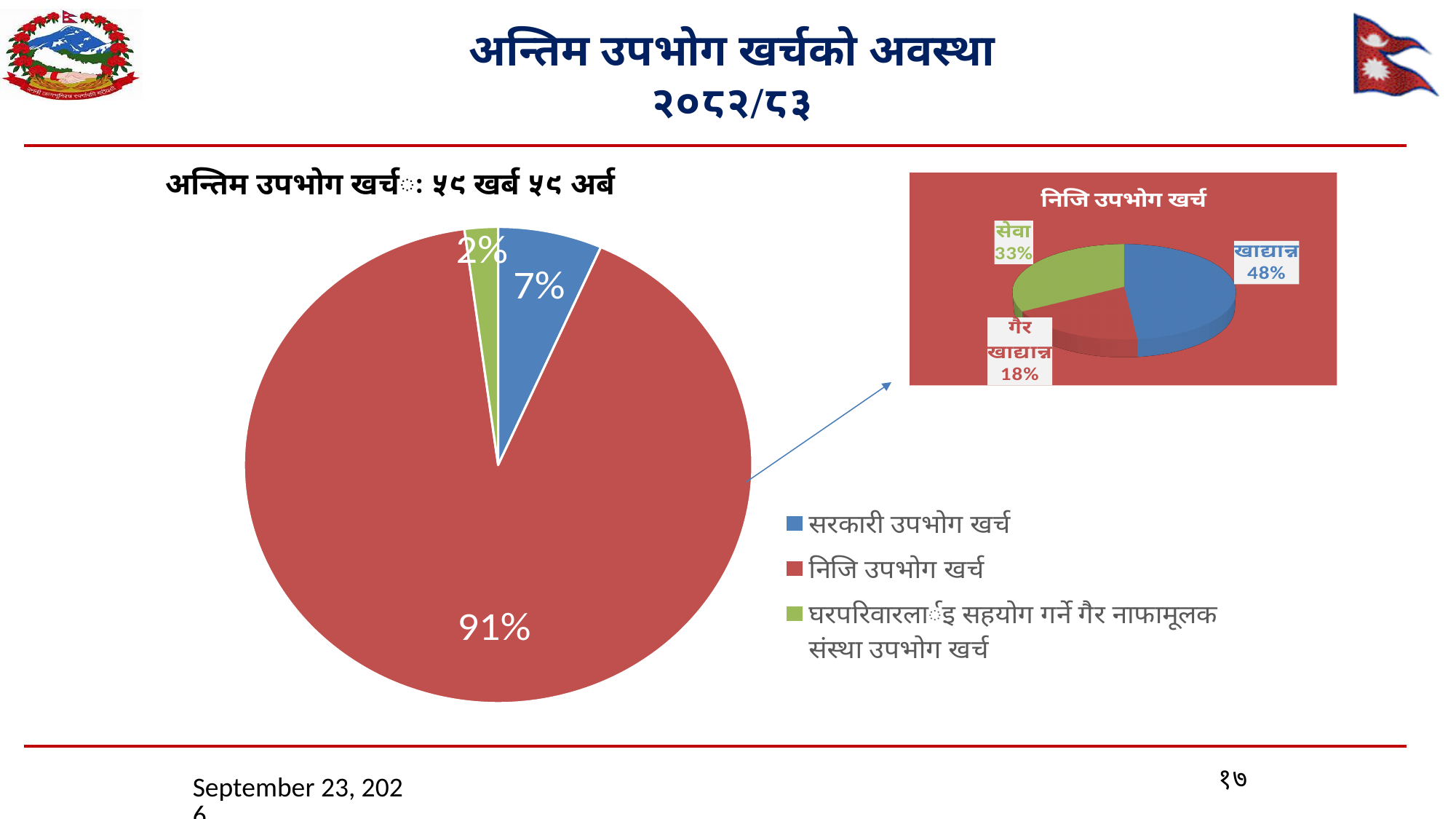
On the large pie chart on the left, how many entries does the legend list? 3 On the large pie chart on the left, which category has the smallest slice? घरपरिवारलाई सहयोग गर्ने गैर नाफामूलक संस्था उपभोग खर्च On the chart titled निजि उपभोग खर्च, what share is labelled for सेवा? 33% What kind of chart is the chart titled निजि उपभोग खर्च on the right? Pie chart On the large pie chart on the left, which category has the largest slice? निजि उपभोग खर्च On the large pie chart on the left, what share is labelled for घरपरिवारलाई सहयोग गर्ने गैर नाफामूलक संस्था उपभोग खर्च? 2% On the chart titled निजि उपभोग खर्च, which category has the smallest slice? गैर खाद्यान्न On the chart titled निजि उपभोग खर्च, what share is labelled for खाद्यान्न? 48% On the chart titled निजि उपभोग खर्च, which is larger, सेवा or गैर खाद्यान्न? सेवा On the large pie chart on the left, what is the difference in percentage points between निजि उपभोग खर्च and सरकारी उपभोग खर्च? 84 percentage points